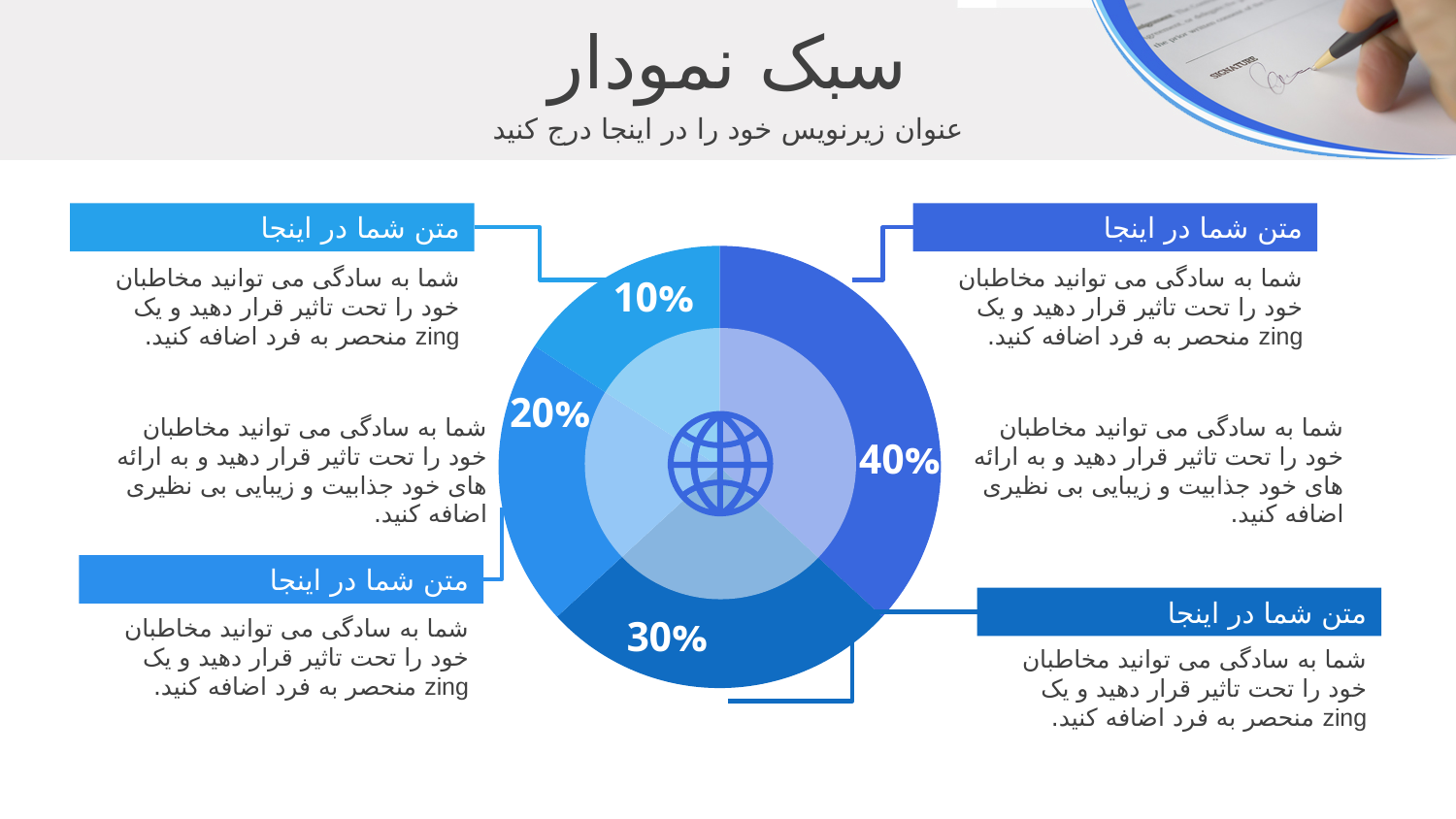
What kind of chart is shown on the slide? pie chart What is the title of the slide containing the pie chart? سبک نمودار What percentage is labelled on the slice on the left side of the pie chart? 20% What percentage is labelled on the slice on the right side of the pie chart? 40% What percentage is labelled on the slice at the top-left of the pie chart? 10% What do the four slice percentages add up to? 100% Which slice is larger, the one labelled 20% or the one labelled 30%? 30% What is the smallest percentage shown on the pie chart? 10% What is the largest percentage shown on the pie chart? 40% What percentage is labelled on the slice at the bottom of the pie chart? 30% What is the difference between the largest slice (40%) and the bottom slice (30%)? 10% How many slices does the pie chart have? 4